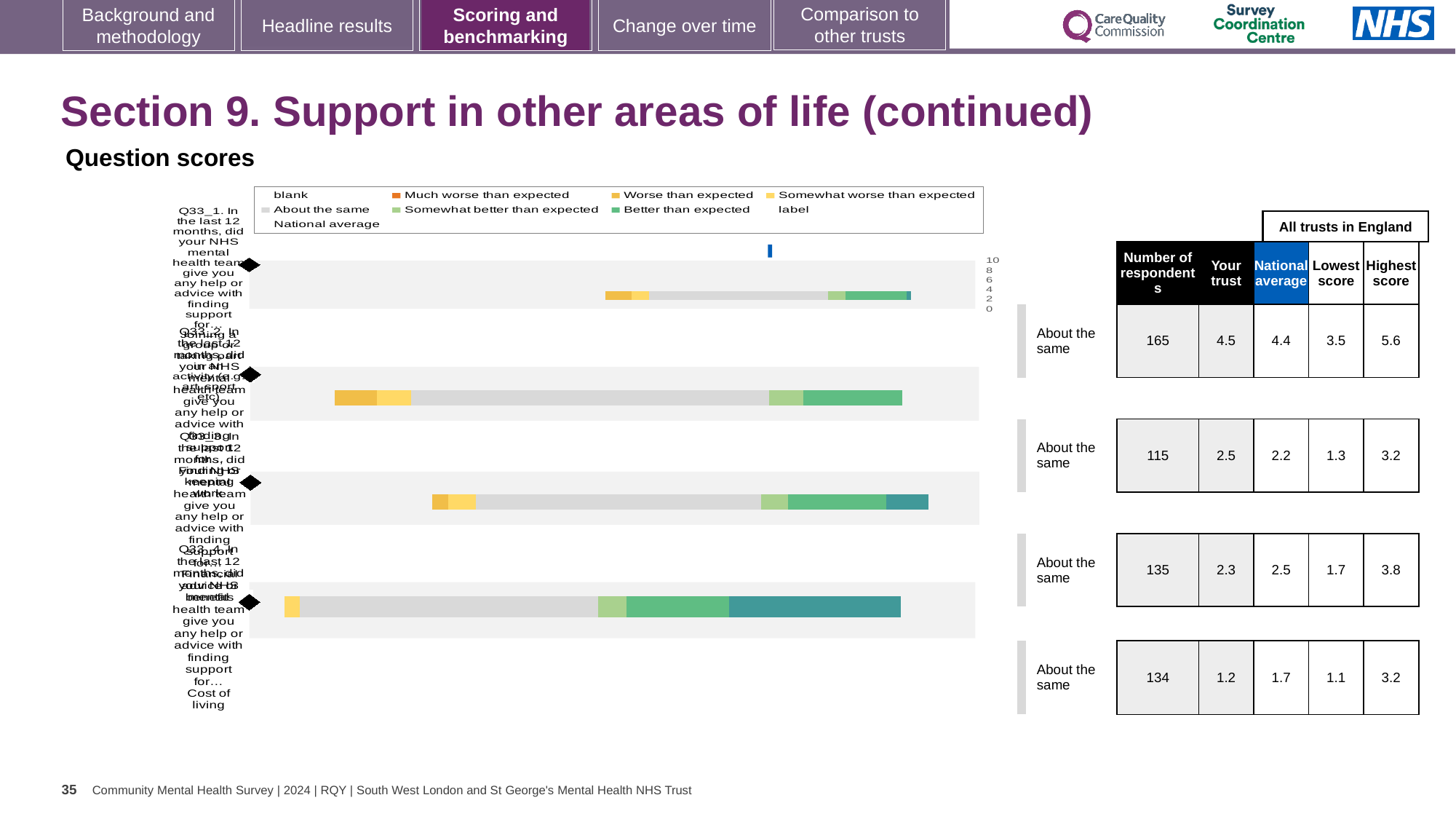
In the table beside the chart, what is the 'National average' for Q33_4? 1.7 How many question bars (Q33_1 to Q33_4) are plotted in the chart? 4 For Q33_3, which is larger: the 'Your trust' score or the 'National average'? National average Which question has the largest number of respondents in the table beside the chart? Q33_1 In the table beside the chart, how many respondents are listed for Q33_2? 115 How many entries does the chart legend list? 9 In the table beside the chart, what is the 'Your trust' score for Q33_1? 4.5 Which question has the lowest 'Your trust' score in the table beside the chart? Q33_4 What kind of chart is shown under 'Question scores'? bar chart For Q33_1, what is the difference between the 'Highest score' and the 'Lowest score' in the table beside the chart? 2.1 In the table beside the chart, what is the 'Highest score' for Q33_3? 3.8 What benchmark label is shown next to each of the four bars in the chart? About the same